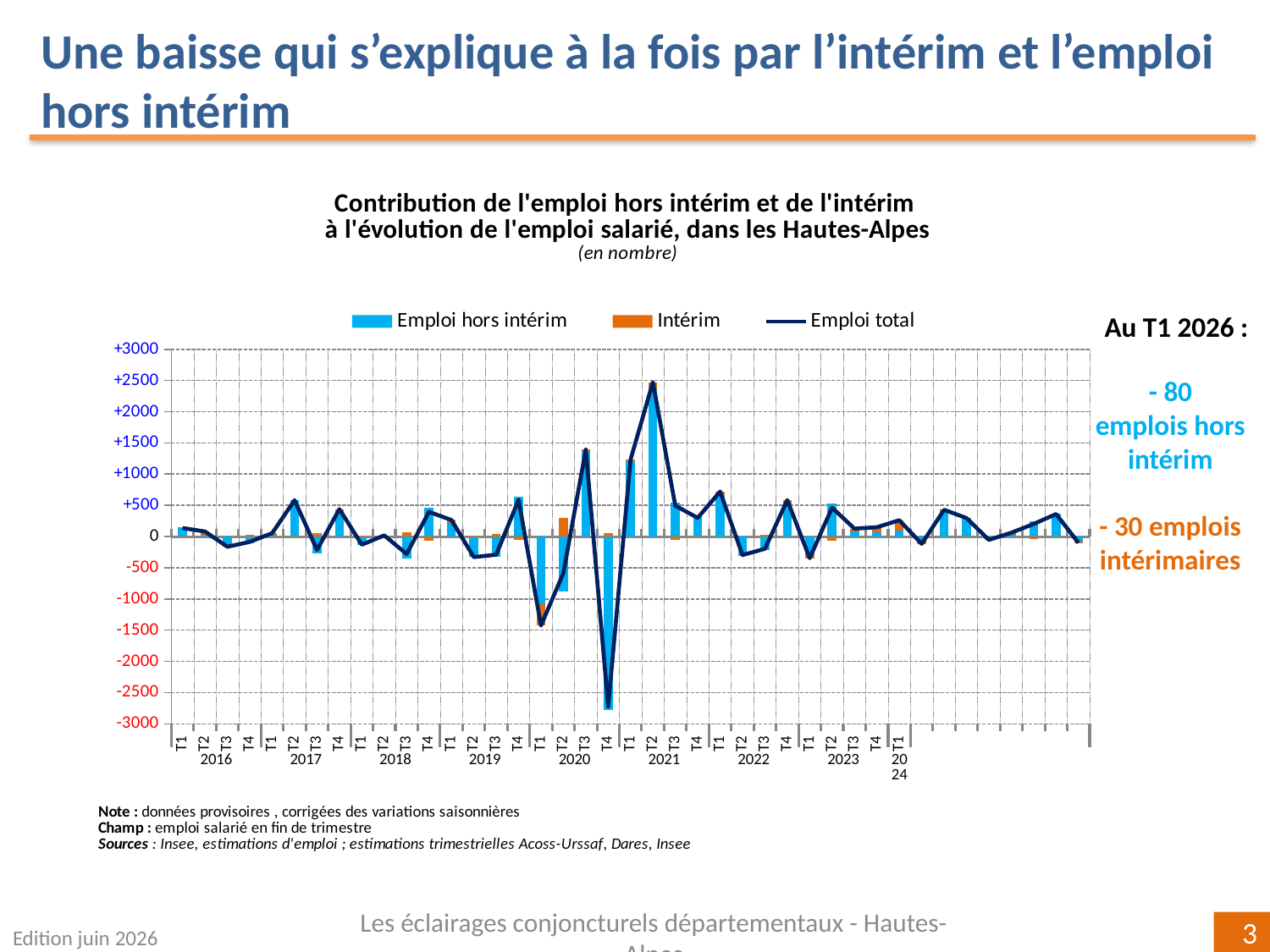
Which is larger, the Emploi hors intérim bar for T2 2021 or for T3 2020? T2 2021 Is the Emploi hors intérim bar for T4 2020 greater or less than -2500? less What kind of chart is shown on the slide? A combined bar and line chart Is the Emploi total value for T1 2020 greater or less than -1000? less In which quarter does the Emploi total line reach its highest point? T2 2021 Which series is shown with orange bars? Intérim In which quarter does the Emploi total line reach its lowest point? T4 2020 Is the Emploi hors intérim bar for T2 2021 greater or less than +2000? greater How many series does the chart legend list? 3 According to the annotation, what is the value for Emploi hors intérim at T1 2026? - 80 Which series is drawn as a line in the chart? Emploi total According to the annotation, what is the value for Intérim at T1 2026? - 30